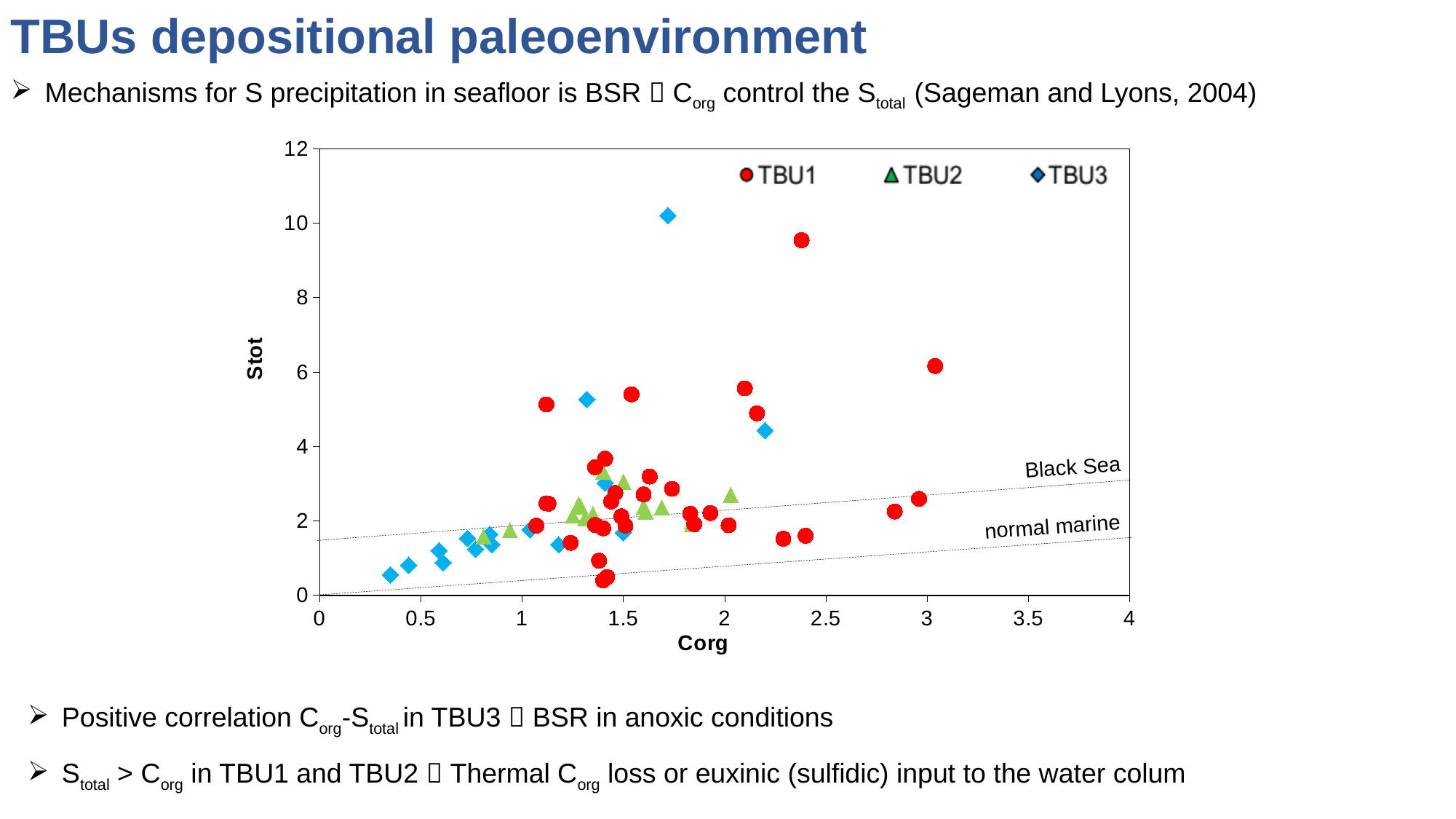
Which series contains the point with the lowest Corg value on the chart? TBU3 Is the lowest Stot value among the TBU3 points greater or less than 1? less What kind of chart is shown on the slide? scatter plot Which series has the most plotted points on the chart? TBU1 Is the highest Stot value among the TBU1 points greater or less than 10? less What is the maximum value shown on the horizontal (Corg) axis? 4 Is the highest Stot value among the TBU2 points greater or less than 4? less What is the label of the vertical axis of the chart? Stot Which series contains the point with the highest Stot value on the chart? TBU3 What is the maximum value shown on the vertical (Stot) axis? 12 What are the names of the series listed in the chart legend? TBU1, TBU2, TBU3 How many series does the chart legend list? 3